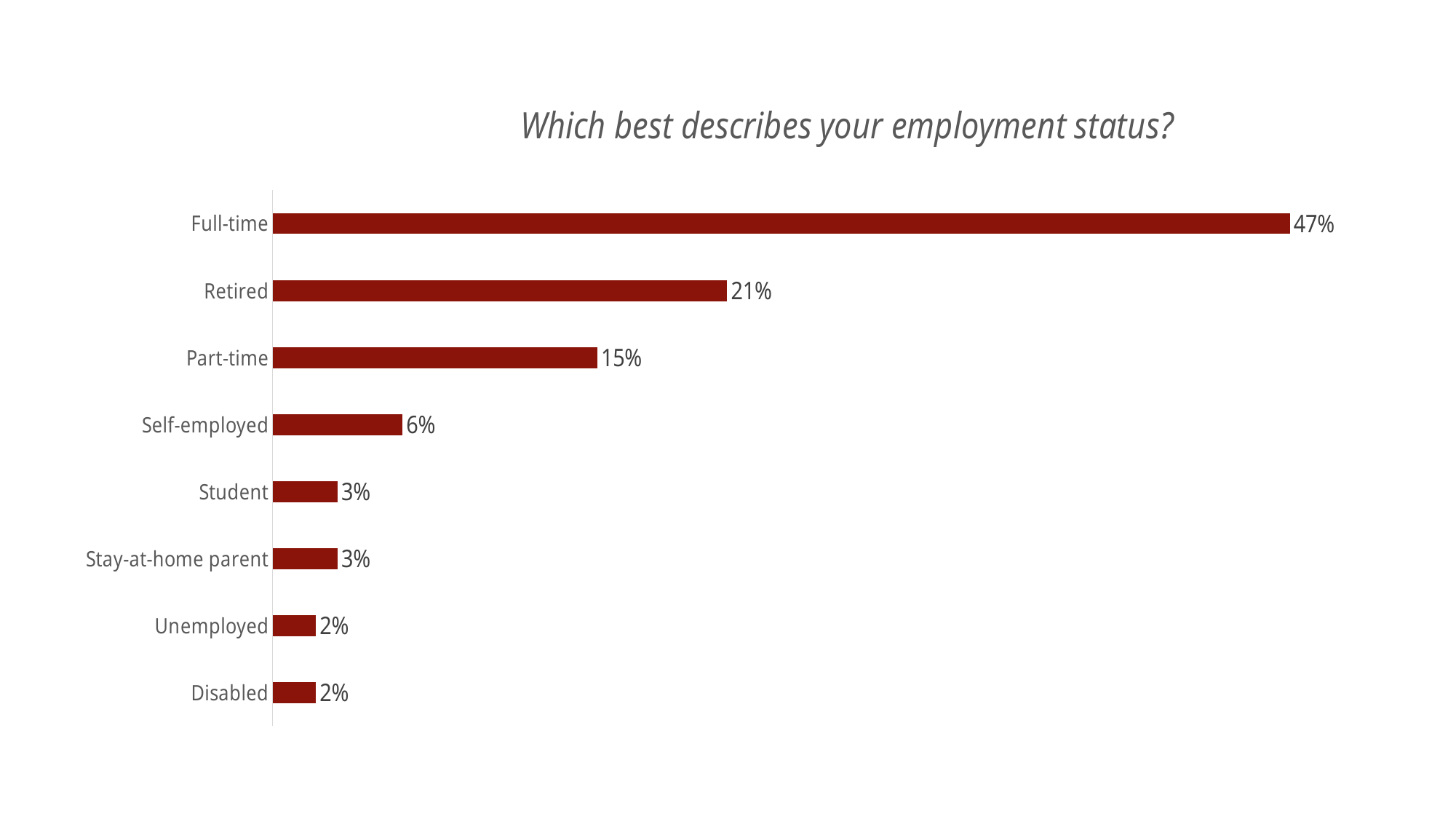
What is the title of the chart? Which best describes your employment status? What is the difference in percentage points between Part-time and Self-employed? 9 How many employment status categories are shown in the chart? 8 What kind of chart is shown on the slide? Bar chart Which is larger, the value for Self-employed or the value for Student? Self-employed What is the value shown for Retired? 21% What is the value shown for Unemployed? 2% Which employment status has the highest percentage? Full-time What percentage of respondents are self-employed? 6% What percentage of respondents are employed full-time? 47% Which is larger, the value for Retired or the value for Part-time? Retired What is the difference in percentage points between Full-time and Retired? 26